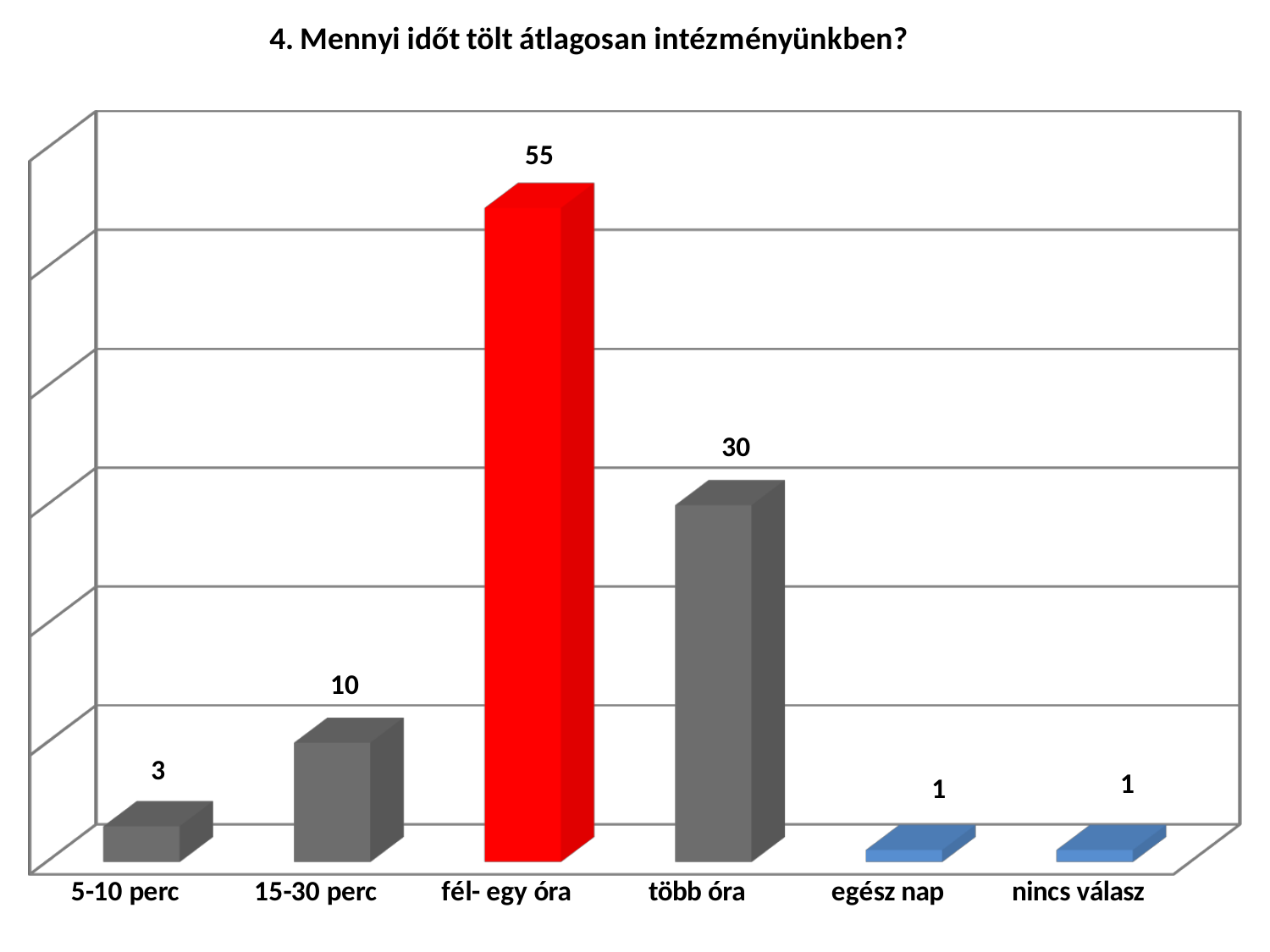
How many categories are shown on the x axis? 6 What is the title of the chart? 4. Mennyi időt tölt átlagosan intézményünkben? Which category's bar is coloured red? fél- egy óra What kind of chart is shown on the slide? bar chart What is the value for "5-10 perc"? 3 Which is larger, the value for "több óra" or the value for "15-30 perc"? több óra What is the difference between the values for "fél- egy óra" and "több óra"? 25 Which category has the highest value? fél- egy óra What is the difference between the values for "15-30 perc" and "5-10 perc"? 7 What is the value for "fél- egy óra"? 55 What is the value for "15-30 perc"? 10 What is the value for "több óra"? 30